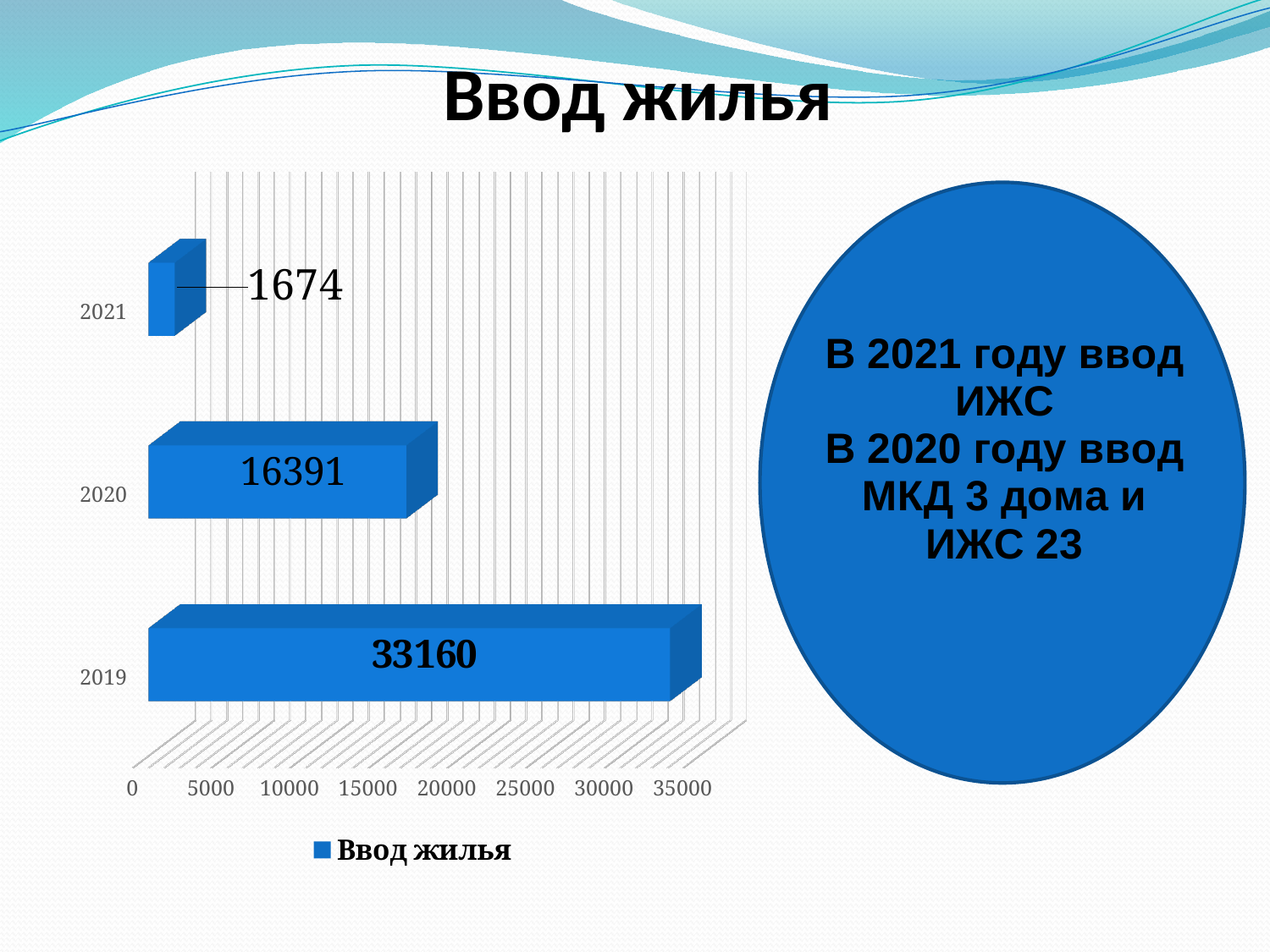
Which is larger, the value for 2020 or the value for 2021? 2020 What is the value for 2019? 33160 How many years are shown in the chart? 3 Which year has the highest value? 2019 What is the difference between the values for 2019 and 2020? 16769 What is the difference between the values for 2020 and 2021? 14717 Is the value for 2019 greater or less than 30000? greater What is the title of the chart? Ввод жилья What is the value for 2020? 16391 What is the value for 2021? 1674 Which year has the lowest value? 2021 What kind of chart is shown on the slide? bar chart